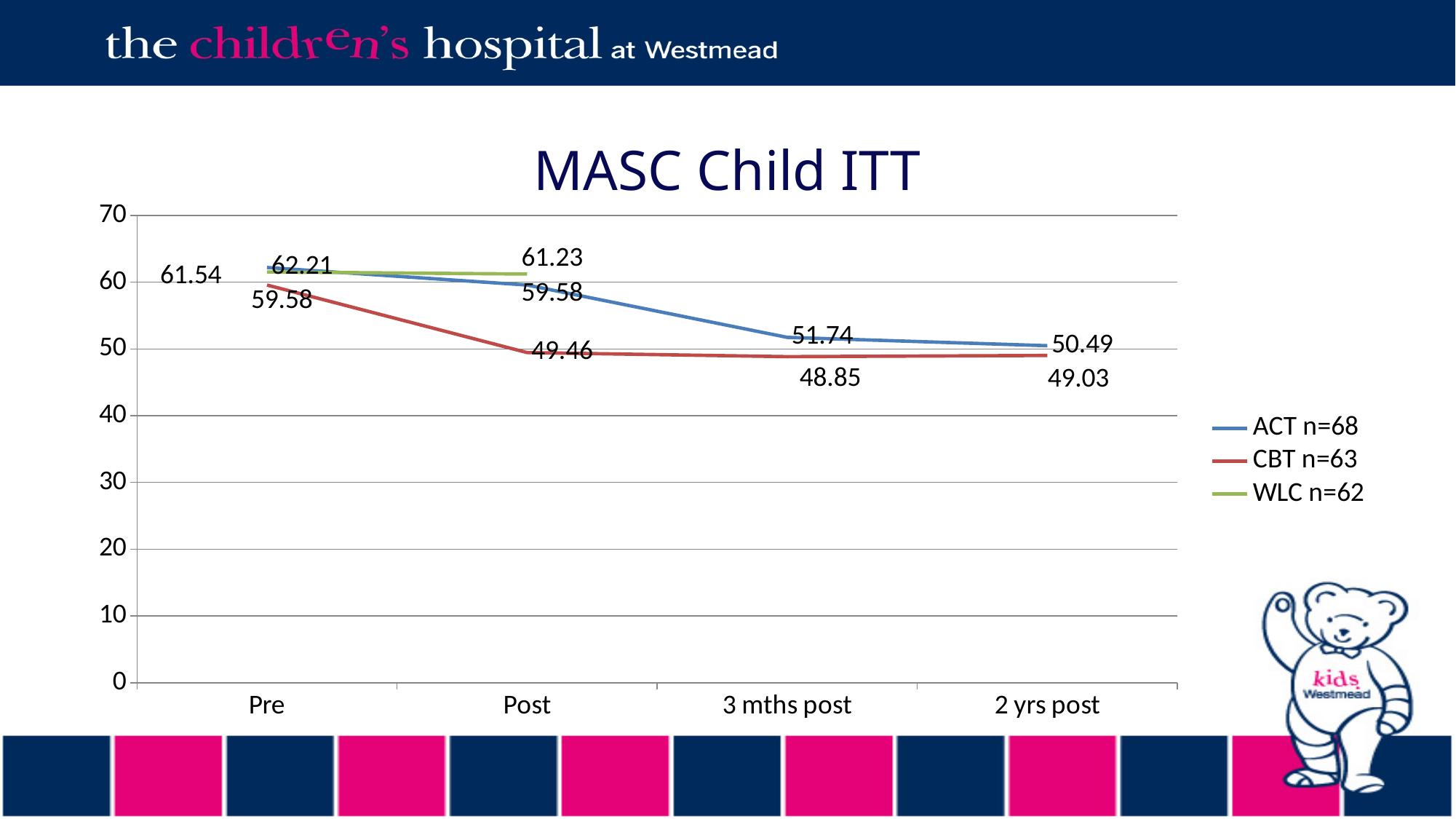
What is the difference between ACT n=68 and CBT n=63 at 2 yrs post? 1.46 Which is larger at Post, ACT n=68 or CBT n=63? ACT n=68 How many series does the legend list? 3 What is the value for WLC n=62 at Post? 61.23 What is the value for CBT n=63 at Post? 49.46 What is the value for CBT n=63 at 3 mths post? 48.85 What is the value for ACT n=68 at 2 yrs post? 50.49 What kind of chart is shown on the slide? line chart By how much did CBT n=63 drop from Pre to Post? 10.12 At which time point is CBT n=63 lowest? 3 mths post How many time points are shown on the x axis? 4 Do the values for ACT n=68 rise or fall from Pre to 2 yrs post? fall